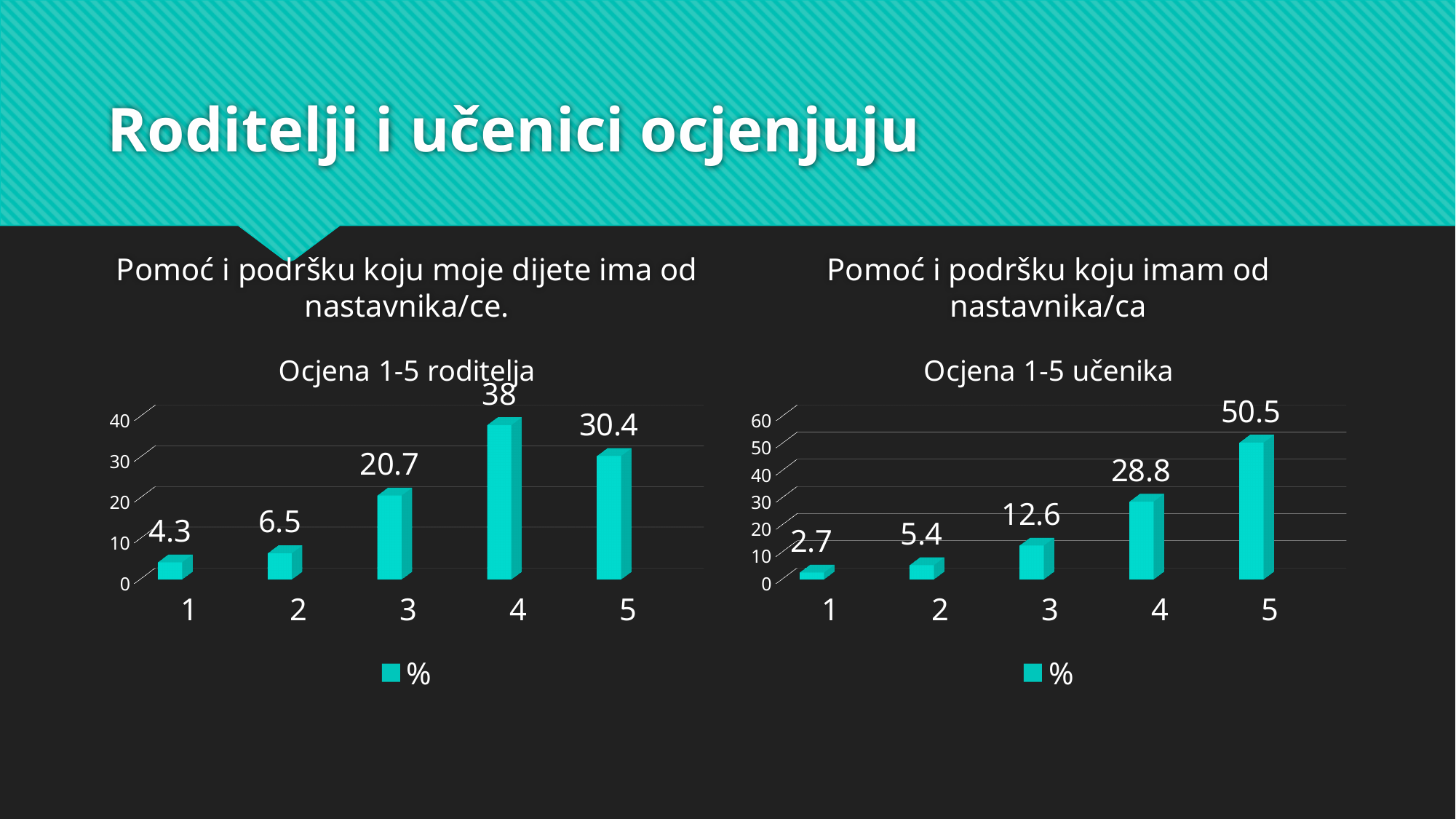
In the chart titled 'Ocjena 1-5 učenika', what is the value for category 3? 12.6 In the chart titled 'Ocjena 1-5 roditelja', what is the difference between the values for category 4 and category 5? 7.6 In the chart titled 'Ocjena 1-5 učenika', which category has the lowest value? 1 In the chart titled 'Ocjena 1-5 roditelja', what is the value for category 4? 38 How many series does the legend of the chart titled 'Ocjena 1-5 učenika' list? 1 What kind of chart is the chart titled 'Ocjena 1-5 učenika'? bar chart In the chart titled 'Ocjena 1-5 učenika', what is the difference between the values for category 5 and category 4? 21.7 In the chart titled 'Ocjena 1-5 roditelja', which category has the highest value? 4 In the chart titled 'Ocjena 1-5 roditelja', which is larger, the value for category 2 or category 3? 3 In the chart titled 'Ocjena 1-5 učenika', is the value for category 5 greater or less than 40? greater In the chart titled 'Ocjena 1-5 učenika', do the values rise or fall from category 1 to category 5? rise How many categories are shown on the x axis of the chart titled 'Ocjena 1-5 roditelja'? 5